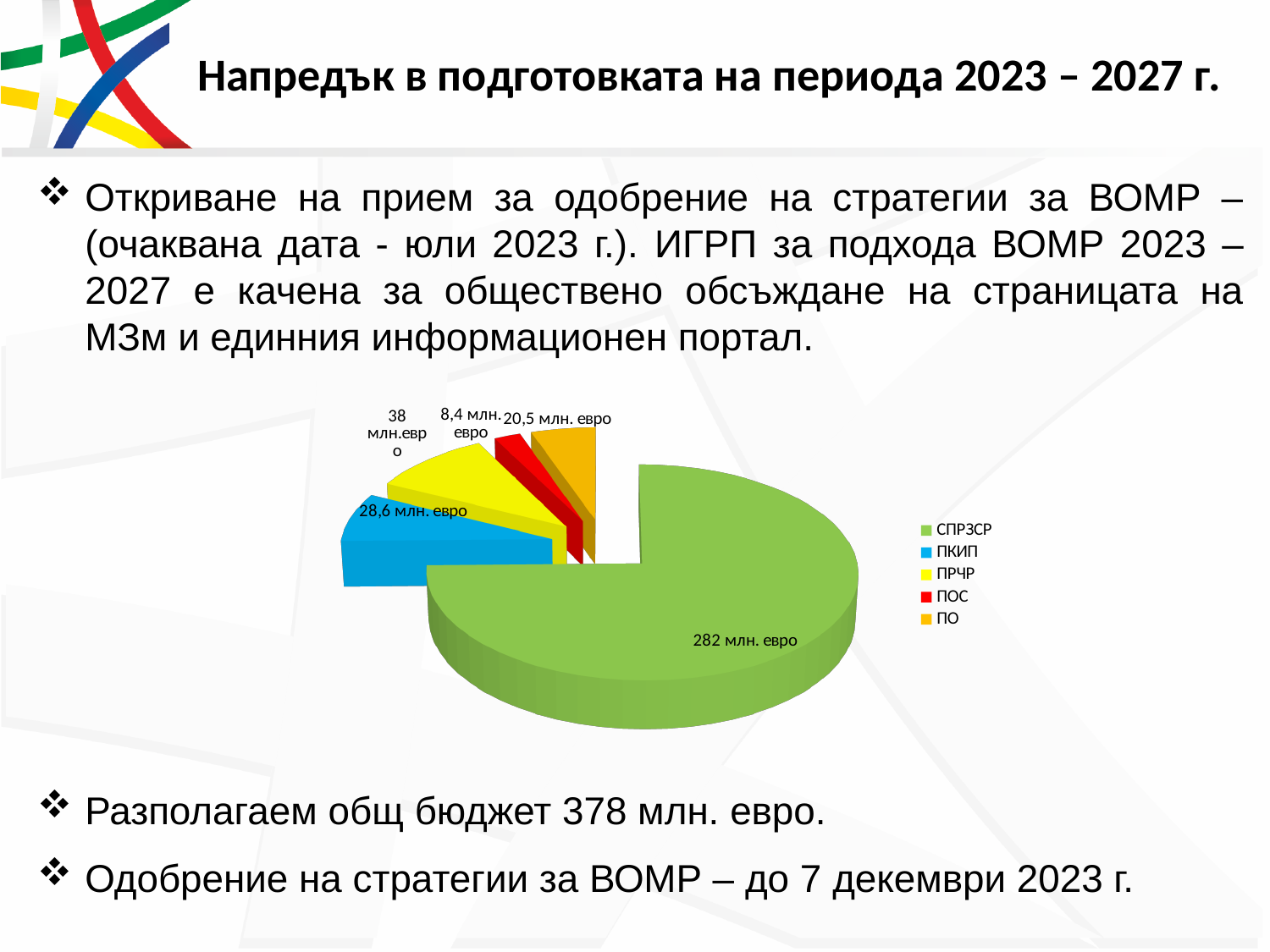
What value is shown for the ПО slice of the pie chart? 20,5 млн. евро What value is shown for the ПОС slice of the pie chart? 8,4 млн. евро What is the difference between the СПРЗСР value and the ПКИП value in the pie chart? 253,4 млн. евро What value is shown for the ПКИП slice of the pie chart? 28,6 млн. евро Which category has the smallest slice in the pie chart? ПОС What value is shown for the СПРЗСР slice of the pie chart? 282 млн. евро How many categories does the pie chart legend list? 5 What value is shown for the ПРЧР slice of the pie chart? 38 млн.евро Which category has the largest slice in the pie chart? СПРЗСР Which is larger in the pie chart, the ПРЧР slice or the ПО slice? ПРЧР What type of chart is shown on the slide? Pie chart What colour is the ПКИП slice in the pie chart? Blue